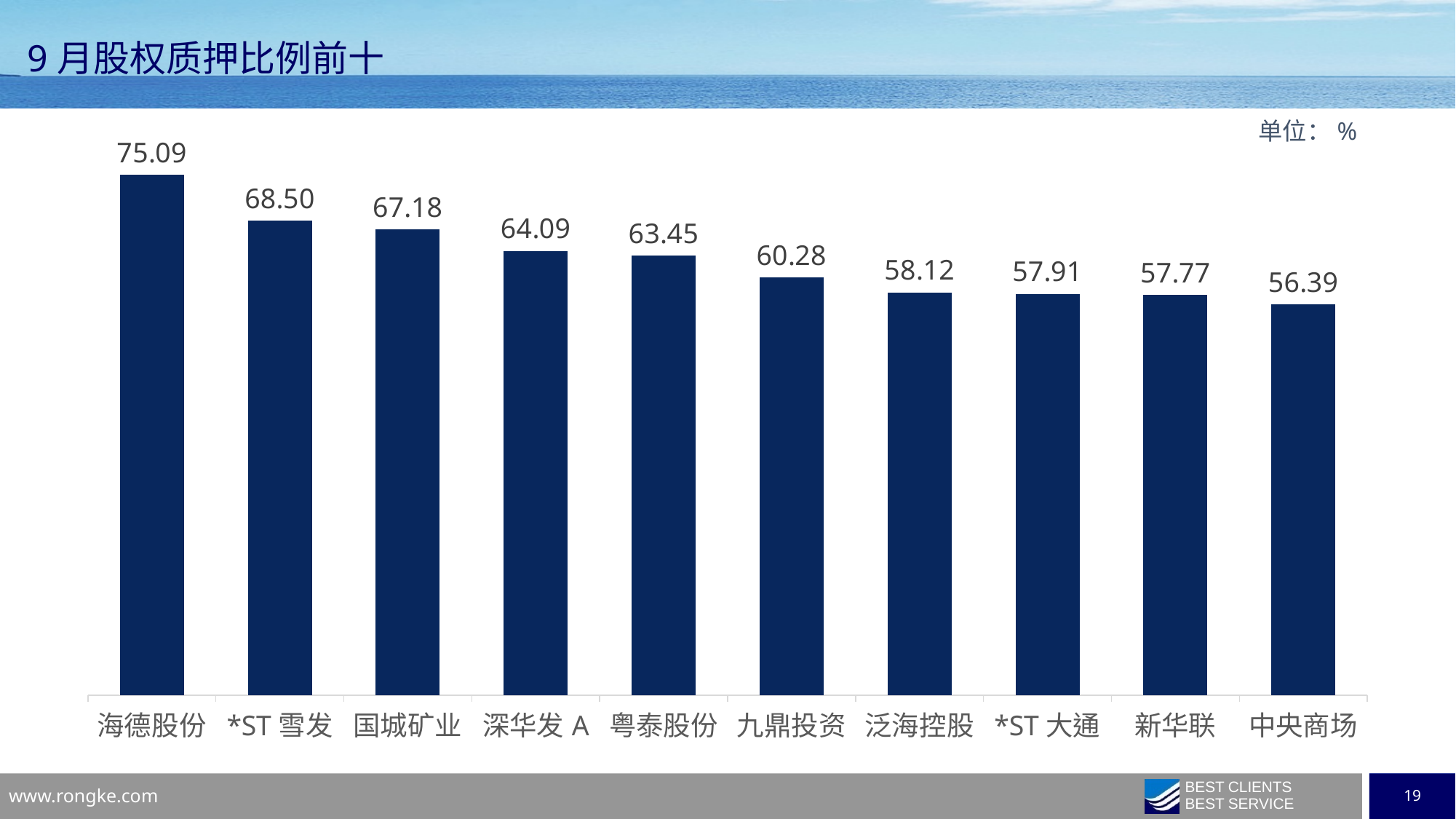
What is the difference between the values for 海德股份 and *ST 雪发? 6.59 Which is larger, the value for 粤泰股份 or the value for 泛海控股? 粤泰股份 Which category has the highest value? 海德股份 What is the value for 海德股份? 75.09 What is the title of the chart? 9 月股权质押比例前十 Do the values rise or fall from left to right along the x axis? fall Which category has the lowest value? 中央商场 What kind of chart is shown on the slide? bar chart What is the value for 中央商场? 56.39 How many categories are shown in the chart? 10 What is the value for 九鼎投资? 60.28 What is the difference between the values for 国城矿业 and 深华发 A? 3.09